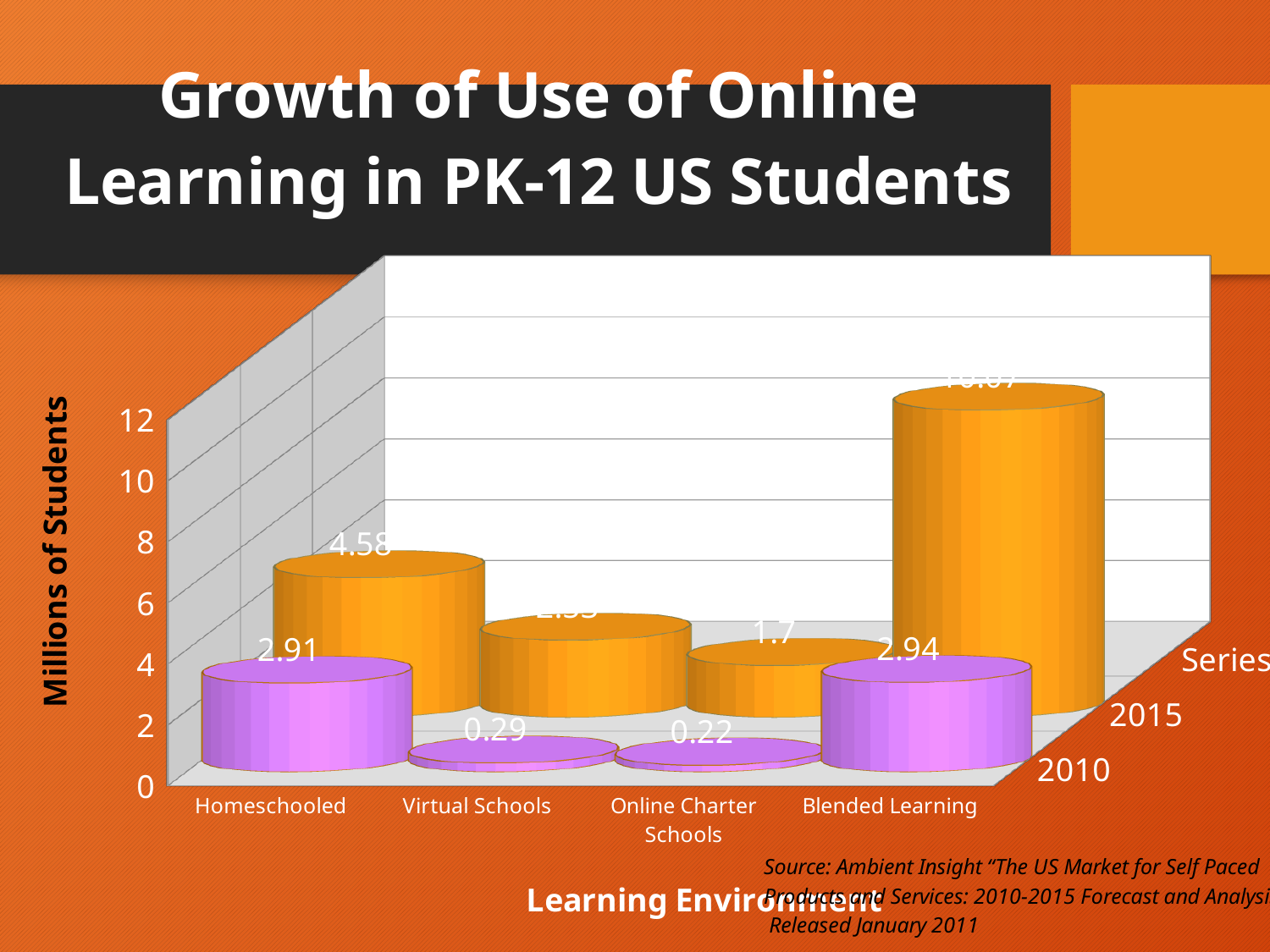
What is the 2015 value for Homeschooled? 4.58 What is the 2010 value for Online Charter Schools? 0.22 What is the 2015 value for Online Charter Schools? 1.7 What is the 2010 value for Homeschooled? 2.91 Which learning environment has the lowest 2010 value? Online Charter Schools What is the 2010 value for Virtual Schools? 0.29 By how much did the Homeschooled value increase from 2010 to 2015? 1.67 What is the 2010 value for Blended Learning? 2.94 Is the 2015 value for Blended Learning greater or less than 8? greater Which learning environment has the highest 2015 value? Blended Learning How many learning environment categories are shown on the x axis? 4 What is the title of the vertical axis? Millions of Students